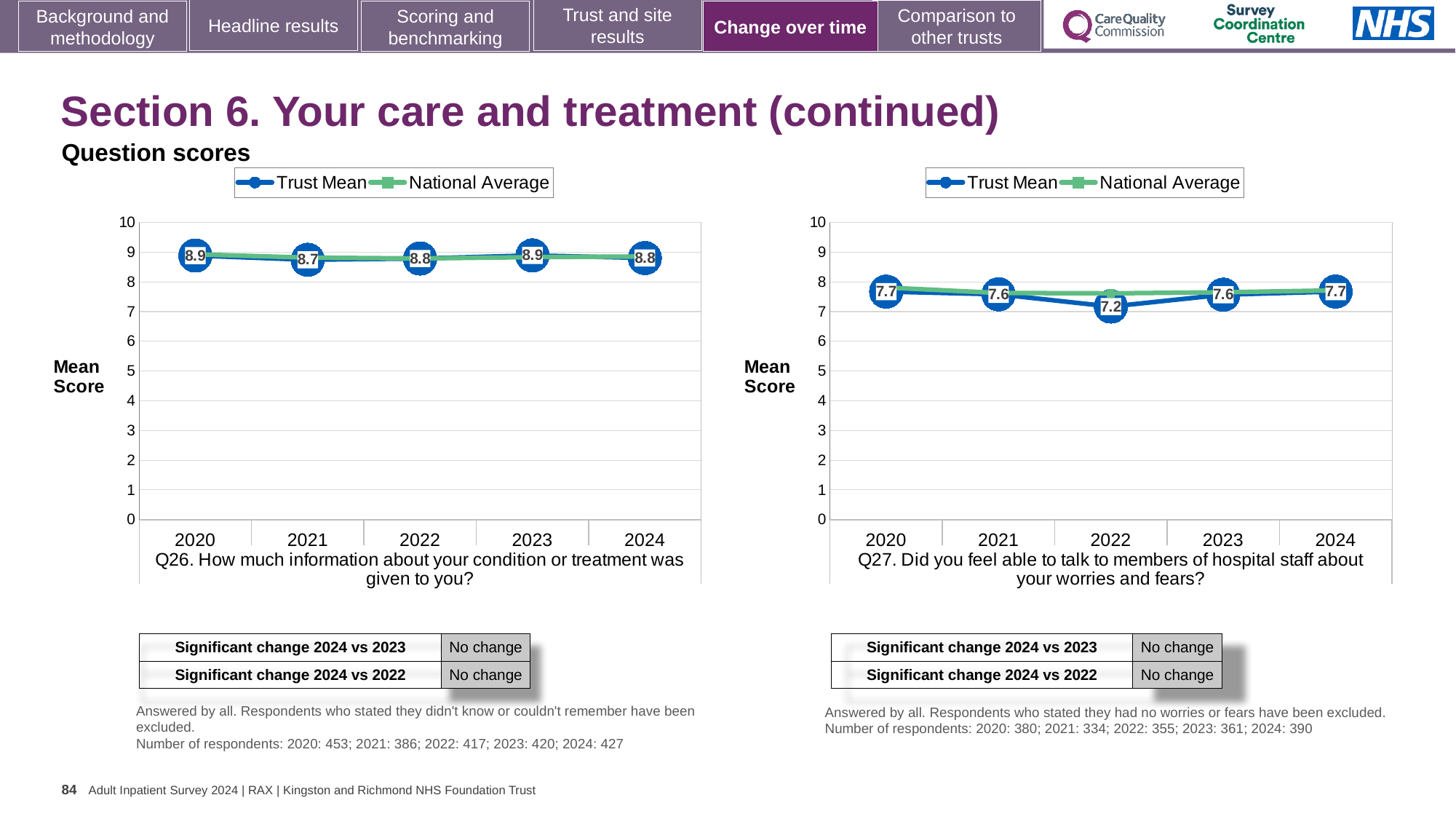
How many years are plotted on the x axis of the Q26 chart? 5 In the Q27 chart, what is the Trust Mean score for 2024? 7.7 In the Q27 chart, is the Trust Mean value for 2022 greater or less than 8? less In the Q26 chart, what is the Trust Mean score for 2020? 8.9 In the Q26 chart, is the Trust Mean score for 2023 larger or smaller than the score for 2021? larger In the Q27 chart, which year has the lowest Trust Mean score? 2022 In the Q26 chart, which year has the lowest Trust Mean score? 2021 What type of chart is used for Q26? line chart How many series does the legend of the Q27 chart list? 2 In the Q27 chart, what is the Trust Mean score for 2022? 7.2 In the Q26 chart, what is the Trust Mean score for 2021? 8.7 In the Q27 chart, what is the difference between the Trust Mean scores for 2020 and 2022? 0.5